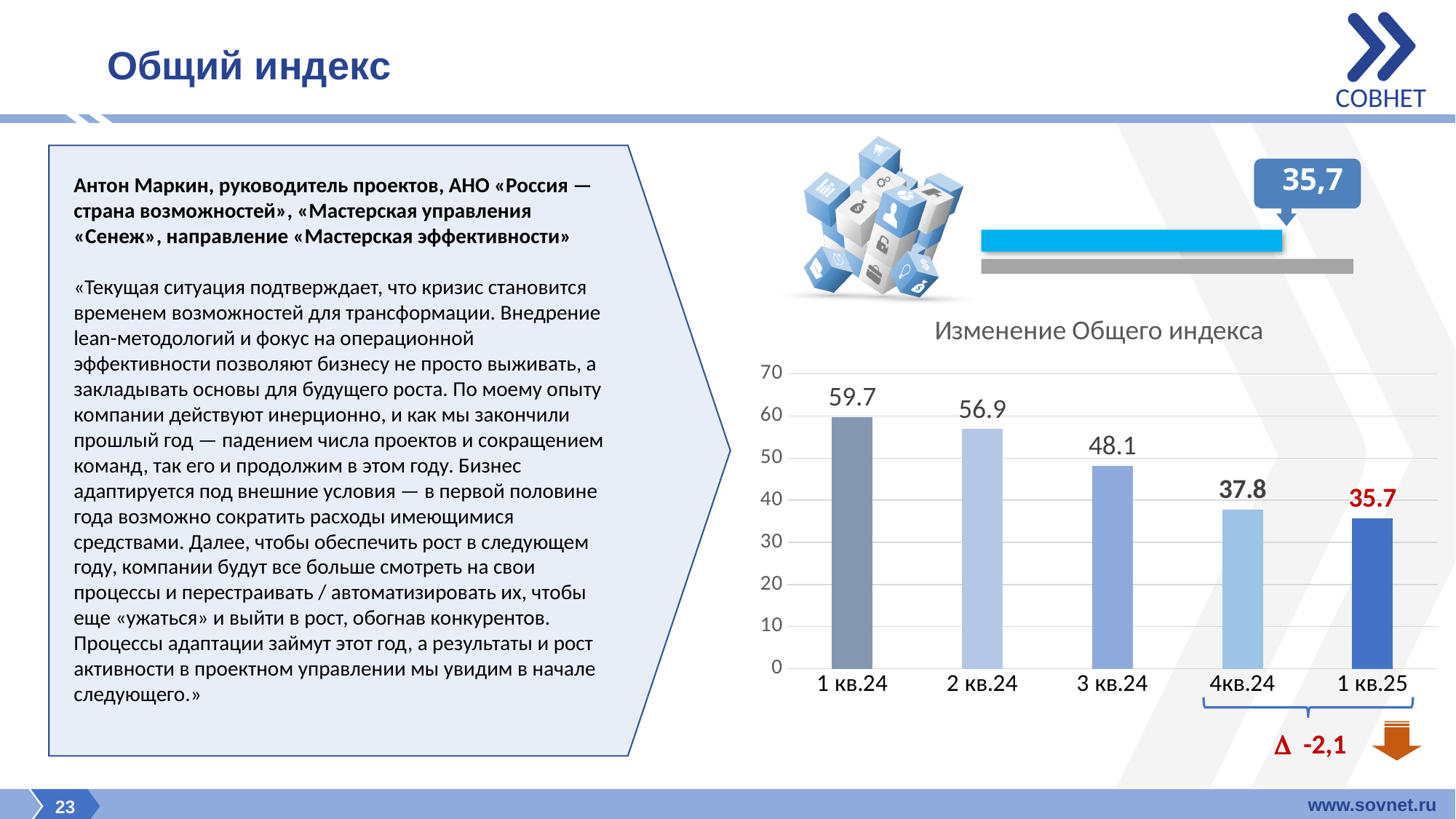
What is the value for 3 кв.24 in the chart "Изменение Общего индекса"? 48.1 In the chart "Изменение Общего индекса", which is larger: the value for 2 кв.24 or the value for 3 кв.24? 2 кв.24 Which quarter has the lowest value in the chart "Изменение Общего индекса"? 1 кв.25 What is the value for 1 кв.24 in the chart "Изменение Общего индекса"? 59.7 How many quarters are shown in the chart "Изменение Общего индекса"? 5 What kind of chart is "Изменение Общего индекса"? Bar chart What is the difference between the values for 1 кв.24 and 2 кв.24 in the chart "Изменение Общего индекса"? 2.8 Which quarter has the highest value in the chart "Изменение Общего индекса"? 1 кв.24 Do the values in the chart "Изменение Общего индекса" rise or fall from 1 кв.24 to 1 кв.25? Fall What is the value for 1 кв.25 in the chart "Изменение Общего индекса"? 35.7 What is the title of the bar chart on the slide? Изменение Общего индекса What is the difference between the values for 4кв.24 and 1 кв.25 in the chart "Изменение Общего индекса"? 2.1